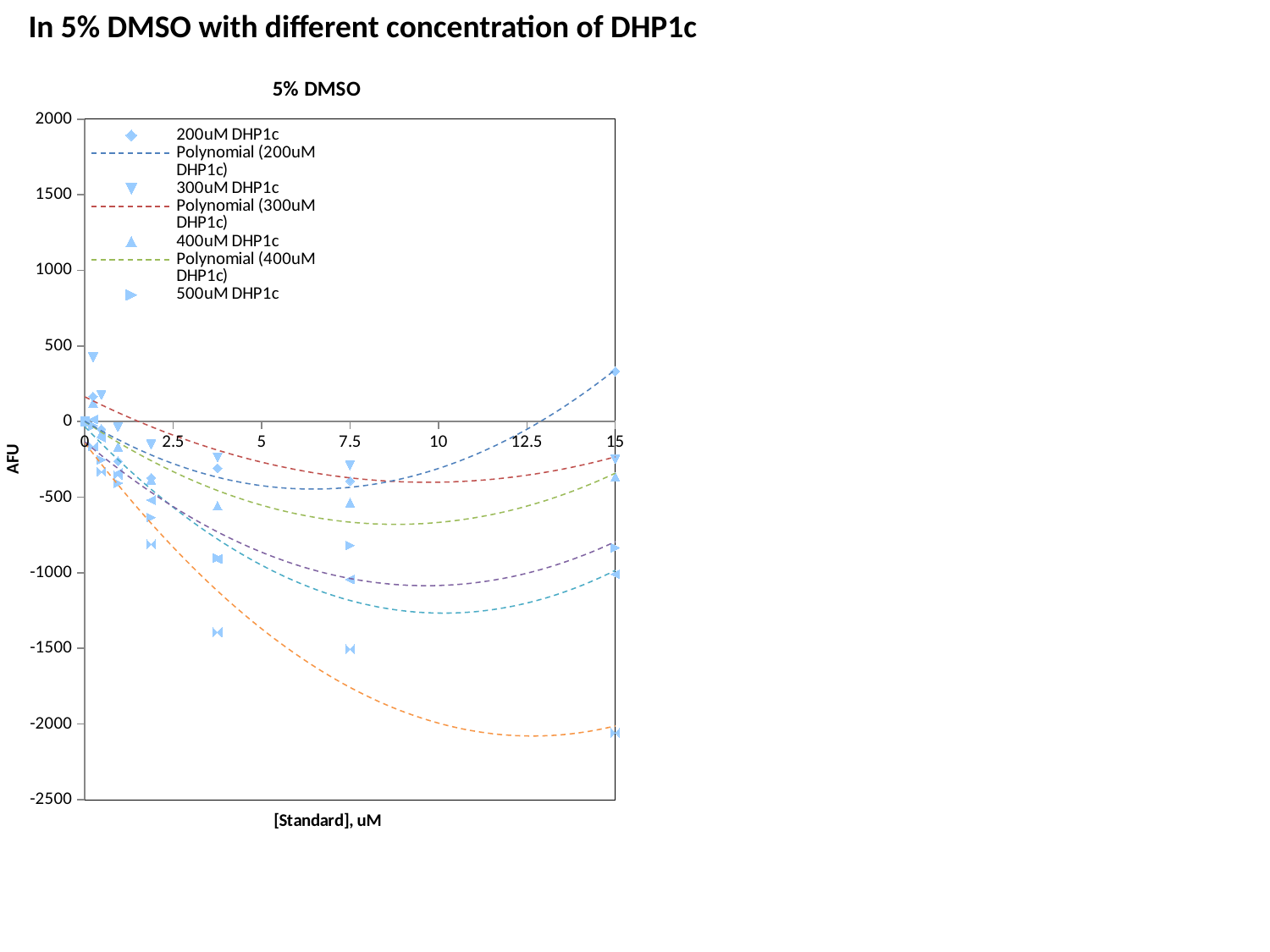
Is the value for 500uM DHP1c at 7.5 uM greater or less than -500? less Is the value for 500uM DHP1c at 15 uM greater or less than -500? less At 7.5 uM, which is higher: 300uM DHP1c or 500uM DHP1c? 300uM DHP1c Of the 200uM, 300uM, 400uM and 500uM DHP1c series, which has the lowest point at 15 uM? 500uM DHP1c At 15 uM, which is higher: 200uM DHP1c or 500uM DHP1c? 200uM DHP1c How many entries does the chart legend list? 7 What is the title of the chart? 5% DMSO What kind of chart is shown on the slide? scatter chart Is the value for 300uM DHP1c at 7.5 uM greater or less than -500? greater What is the label of the y axis? AFU Of the 200uM, 300uM, 400uM and 500uM DHP1c series, which has the highest point at 15 uM? 200uM DHP1c